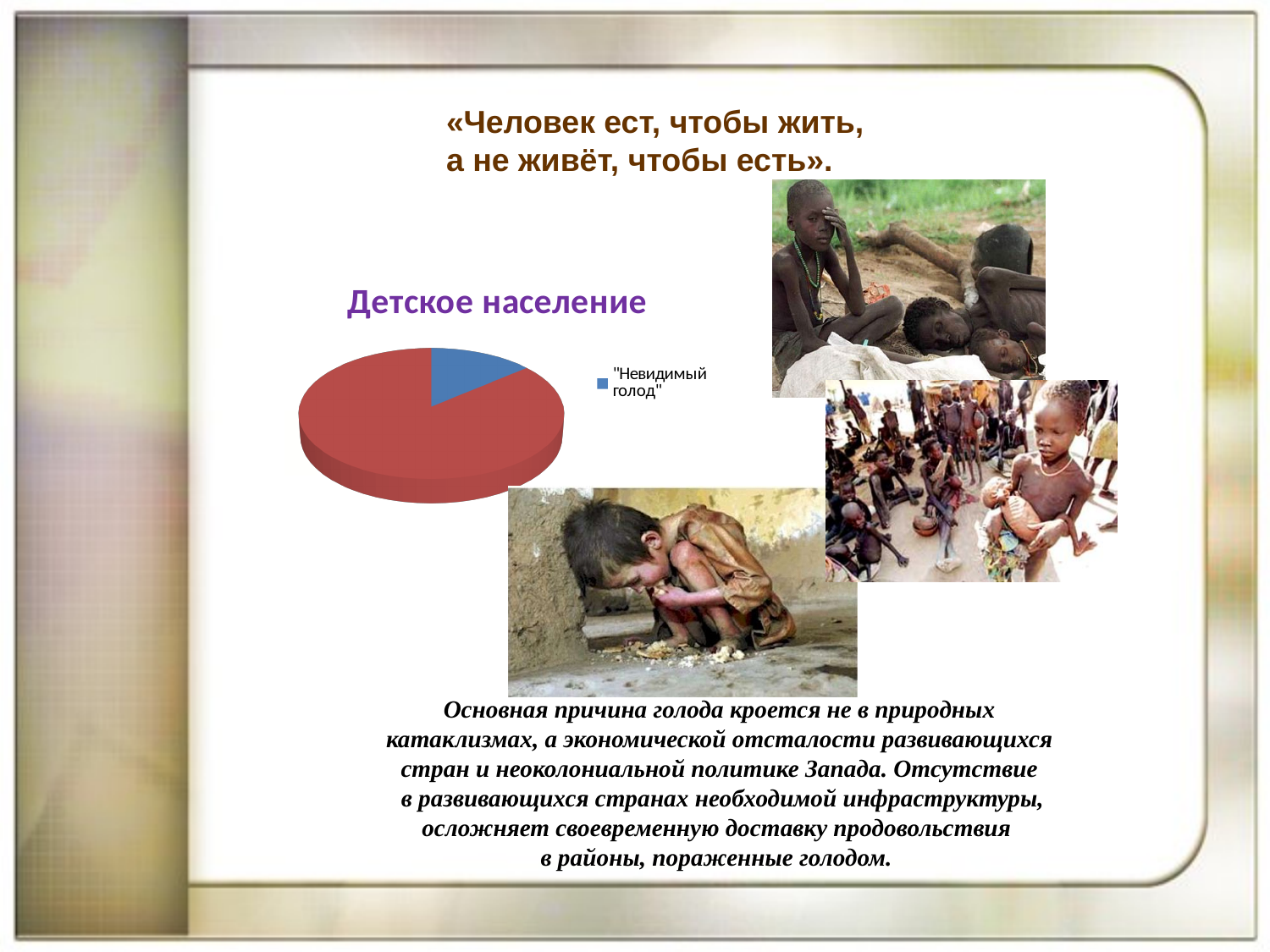
What is the title of the pie chart? Детское население Which slice of the pie chart is the smallest? "Невидимый голод" What is the legend entry shown next to the pie chart? "Невидимый голод" How many entries does the legend of the pie chart list? 1 How many slices does the pie chart have? 2 What kind of chart is shown on the slide? pie chart Which slice of the pie chart is larger, the blue one or the red one? the red one Is the slice for "Невидимый голод" larger or smaller than half of the pie? smaller